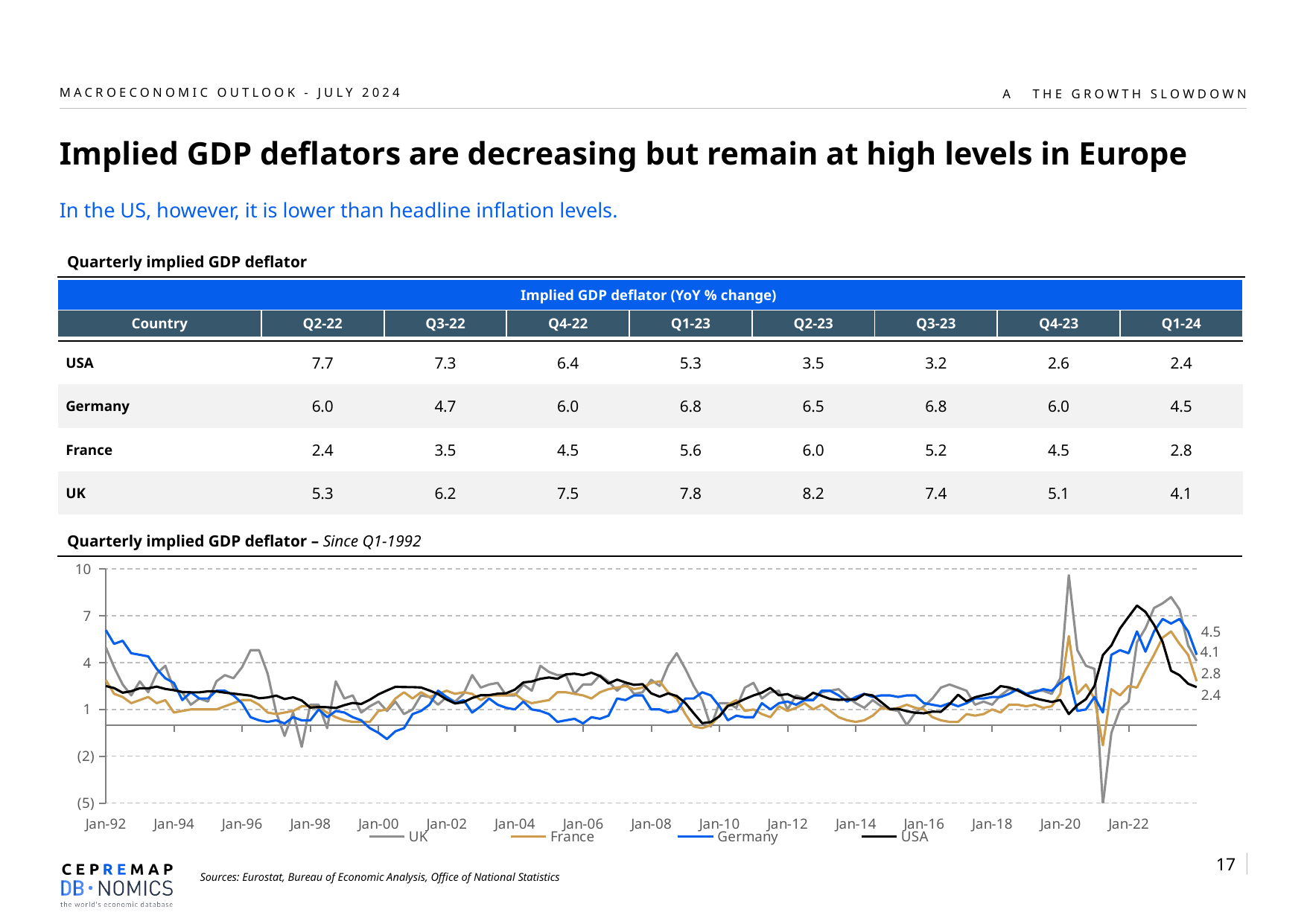
In the line chart, which series has the lowest value at the end of the period? USA In the line chart, which series has the highest value at the end of the period? Germany In the line chart, does the USA line rise or fall between its 2022 peak and the end of the series? fall In the line chart, what is the latest value labelled at the end of the USA line? 2.4 In the line chart, what is the difference between the end-of-period values of Germany and the USA? 2.1 In the line chart, what is the latest value labelled at the end of the UK line? 4.1 In the line chart, is the peak of the UK line around Jan-20 greater or less than 7? greater In the line chart, what is the latest value labelled at the end of the Germany line? 4.5 In the line chart, is the lowest point of the UK line shortly after Jan-20 greater or less than (2)? less What kind of chart is shown under the heading 'Quarterly implied GDP deflator – Since Q1-1992'? line chart How many series does the legend of the line chart list? 4 What colour is the Germany line in the line chart? blue